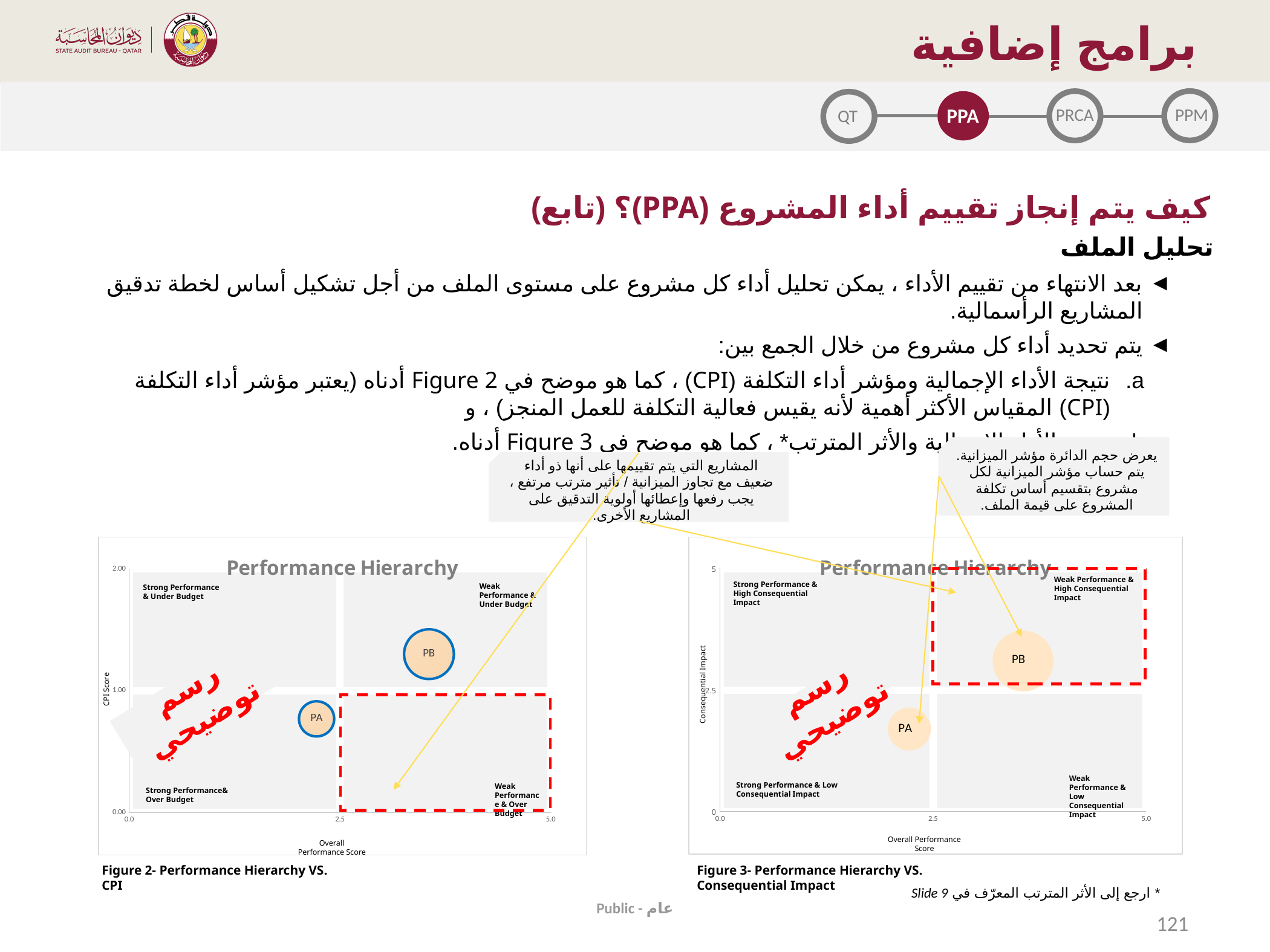
In Figure 3 (Performance Hierarchy VS. Consequential Impact), which project has the higher Overall Performance Score, PA or PB? PB In Figure 2 (Performance Hierarchy VS. CPI), which quadrant does PB fall in? Weak Performance & Under Budget What is the label of the y axis in Figure 3 (Performance Hierarchy VS. Consequential Impact)? Consequential Impact In Figure 2 (Performance Hierarchy VS. CPI), is the CPI Score for PA greater or less than 1.00? less In Figure 3 (Performance Hierarchy VS. Consequential Impact), is the Consequential Impact for PA greater or less than 2.5? less In Figure 3 (Performance Hierarchy VS. Consequential Impact), is the Overall Performance Score for PA greater or less than 2.5? less How many projects (bubbles) are plotted in Figure 2 (Performance Hierarchy VS. CPI)? 2 In Figure 2 (Performance Hierarchy VS. CPI), which project has the higher CPI Score, PA or PB? PB What kind of chart is Figure 2 (Performance Hierarchy VS. CPI)? Bubble chart